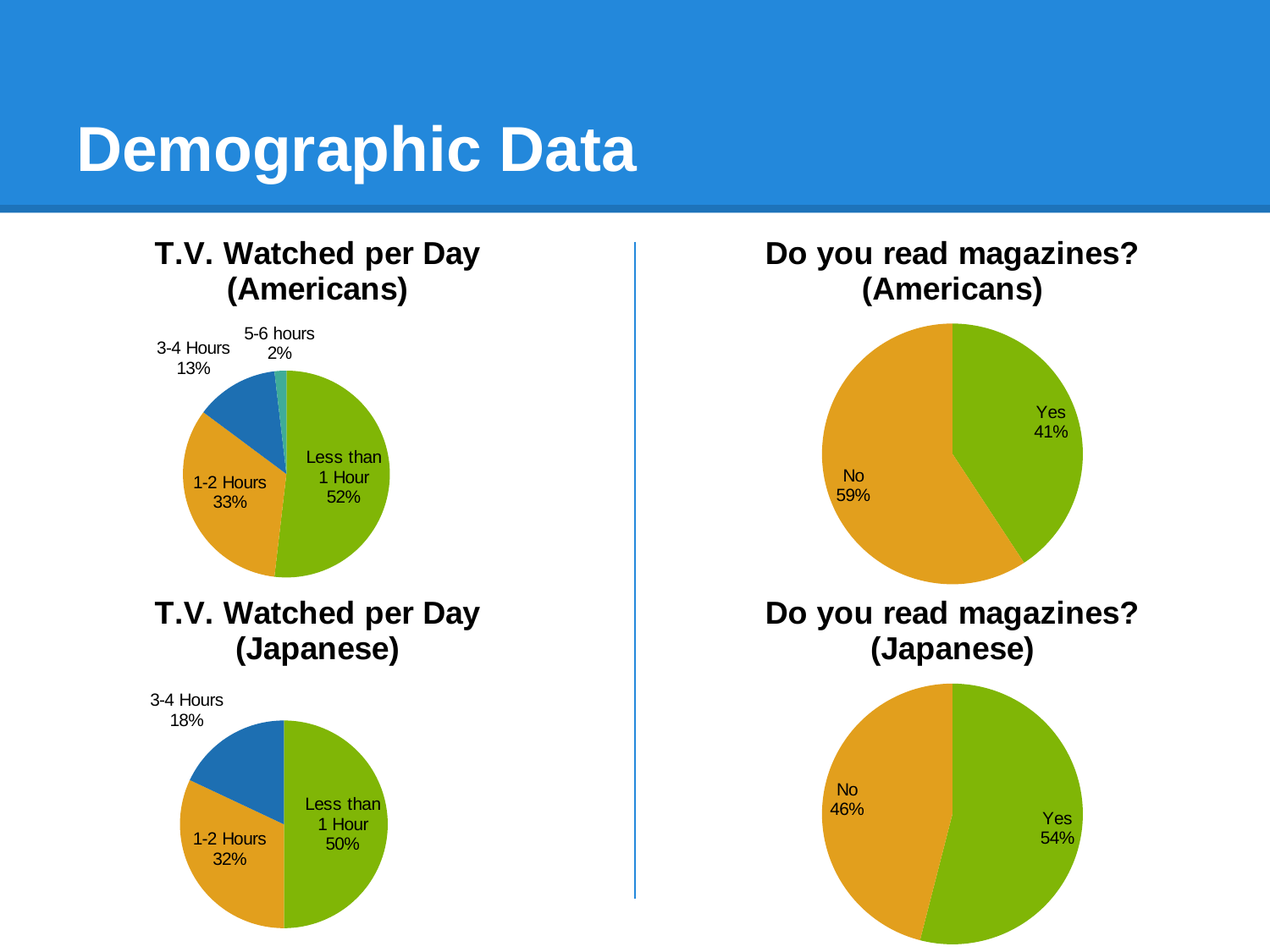
In the 'T.V. Watched per Day (Americans)' chart, what is the value for '3-4 Hours'? 13% In the 'Do you read magazines? (Americans)' chart, which is larger, 'Yes' or 'No'? No In the 'T.V. Watched per Day (Japanese)' chart, what is the value for '1-2 Hours'? 32% In the 'Do you read magazines? (Japanese)' chart, what is the value for 'Yes'? 54% What kind of chart is the 'Do you read magazines? (Japanese)' chart? Pie chart In the 'T.V. Watched per Day (Americans)' chart, what share of the pie is 'Less than 1 Hour'? 52% In the 'T.V. Watched per Day (Japanese)' chart, what is the difference between 'Less than 1 Hour' and '3-4 Hours'? 32% In the 'T.V. Watched per Day (Americans)' chart, how many categories are shown? 4 In the 'Do you read magazines? (Japanese)' chart, what is the difference between 'Yes' and 'No'? 8% In the 'Do you read magazines? (Americans)' chart, what share of the pie is 'No'? 59% In the 'T.V. Watched per Day (Americans)' chart, which category has the smallest slice? 5-6 hours In the 'T.V. Watched per Day (Japanese)' chart, which category has the largest slice? Less than 1 Hour